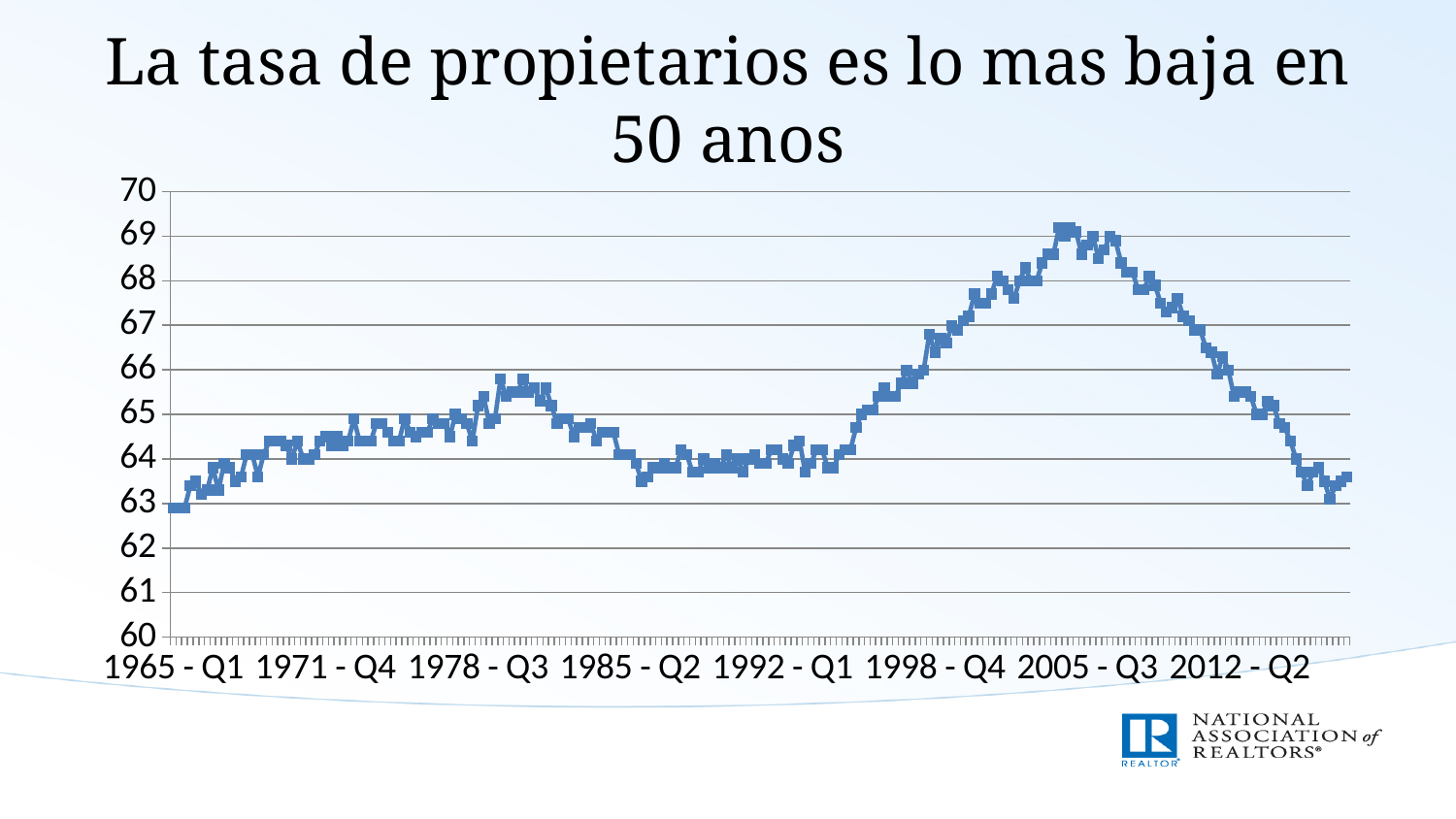
Of the labeled x-axis points, which has the highest value? 2005 - Q3 Is the value at 1998 - Q4 greater or less than 65? greater Is the value at 2012 - Q2 greater or less than 66? less Does the line rise or fall between 1992 - Q1 and 2005 - Q3? rise What is the first x-axis label on the chart? 1965 - Q1 Which is larger, the value at 1998 - Q4 or the value at 1985 - Q2? 1998 - Q4 Is the value at 1965 - Q1 greater or less than 64? less Does the line rise or fall between 2005 - Q3 and 2012 - Q2? fall What is the title of the slide's chart? La tasa de propietarios es lo mas baja en 50 anos What kind of chart is shown on the slide? line chart